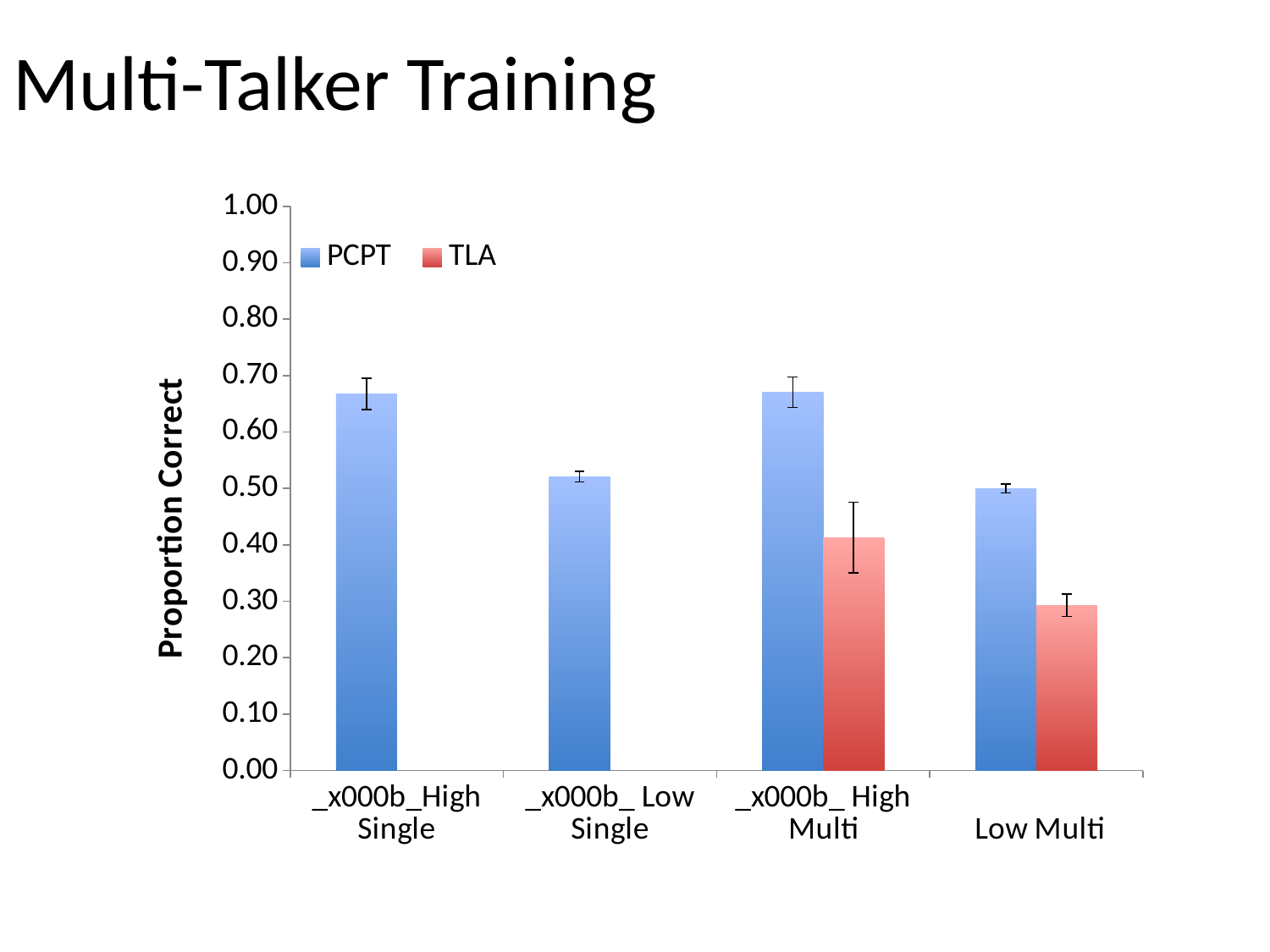
What is the title of the y axis? Proportion Correct Is the PCPT value for High Single greater or less than 0.60? greater For the TLA series, which category has the higher value, High Multi or Low Multi? High Multi In the High Multi category, which series has the larger value, PCPT or TLA? PCPT How many series does the legend list? 2 Is the TLA value for High Multi greater or less than 0.30? greater What kind of chart is shown on the slide? bar chart Is the PCPT value for Low Single greater or less than 0.60? less Which categories have no TLA bar? High Single and Low Single How many categories are shown on the x axis? 4 Which series is shown in red? TLA